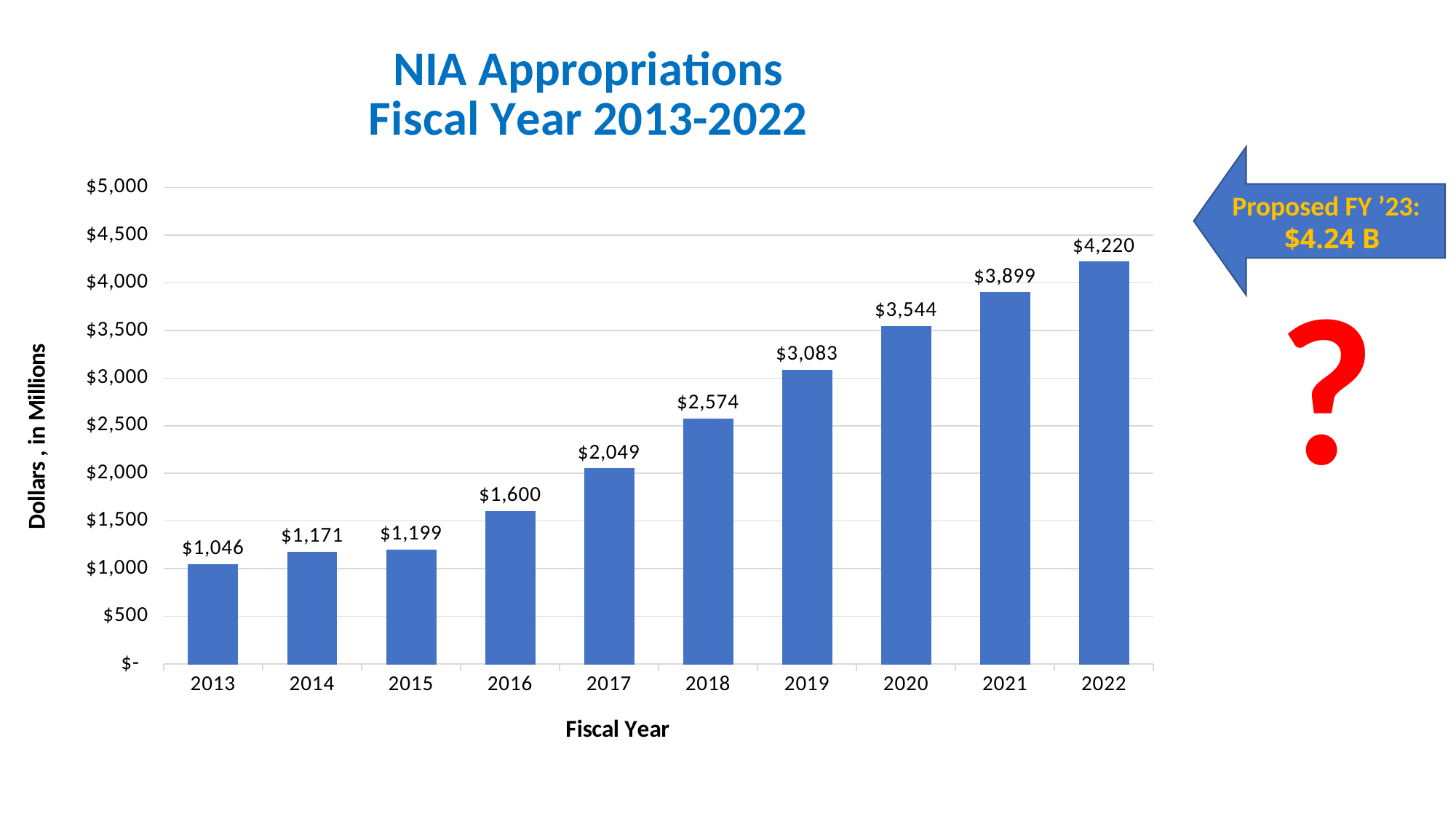
How many fiscal years are shown in the chart? 10 Do the appropriations rise or fall from 2013 to 2022? Rise Which fiscal year had the lowest NIA appropriation? 2013 What was the NIA appropriation for fiscal year 2020? $3,544 What is the title of the chart? NIA Appropriations Fiscal Year 2013-2022 Which fiscal year had a larger appropriation, 2016 or 2018? 2018 Which fiscal year had the highest NIA appropriation? 2022 What kind of chart is shown on the slide? Bar chart What is the difference between the 2022 and 2021 appropriations? $321 What was the NIA appropriation for fiscal year 2013? $1,046 What is the difference between the 2019 and 2018 appropriations? $509 What was the NIA appropriation for fiscal year 2017? $2,049